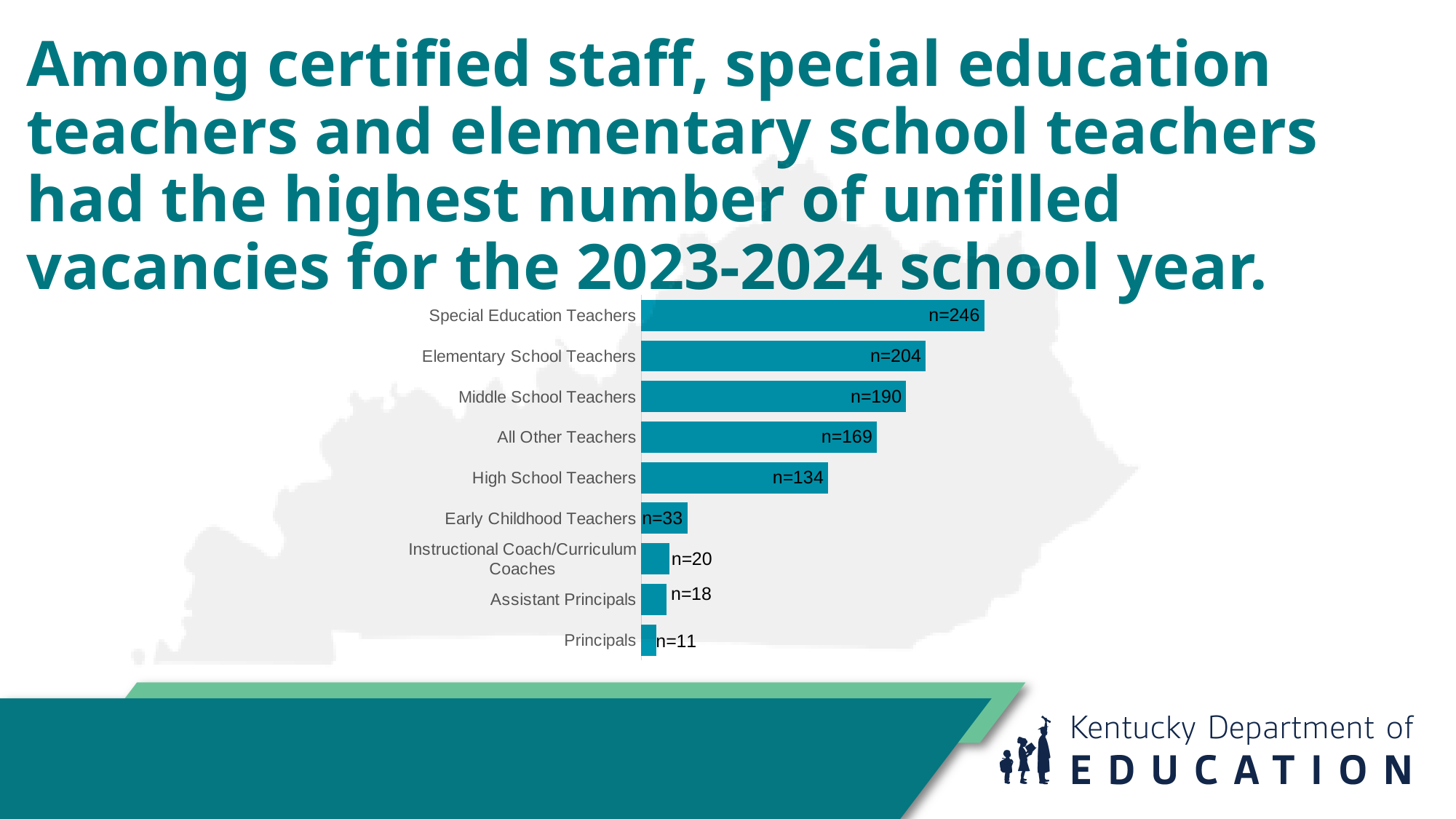
What is the number of unfilled vacancies for High School Teachers? n=134 Which category has the lowest number of unfilled vacancies? Principals What is the difference in unfilled vacancies between Middle School Teachers and All Other Teachers? 21 What is the number of unfilled vacancies for Special Education Teachers? n=246 What is the difference in unfilled vacancies between Special Education Teachers and Elementary School Teachers? 42 Which has more unfilled vacancies, High School Teachers or Middle School Teachers? Middle School Teachers What kind of chart is shown on the slide? Bar chart What is the number of unfilled vacancies for Assistant Principals? n=18 How many categories are shown in the chart? 9 What is the total number of unfilled vacancies for Principals and Assistant Principals combined? 29 Which category has the highest number of unfilled vacancies? Special Education Teachers Which has more unfilled vacancies, Early Childhood Teachers or Instructional Coach/Curriculum Coaches? Early Childhood Teachers